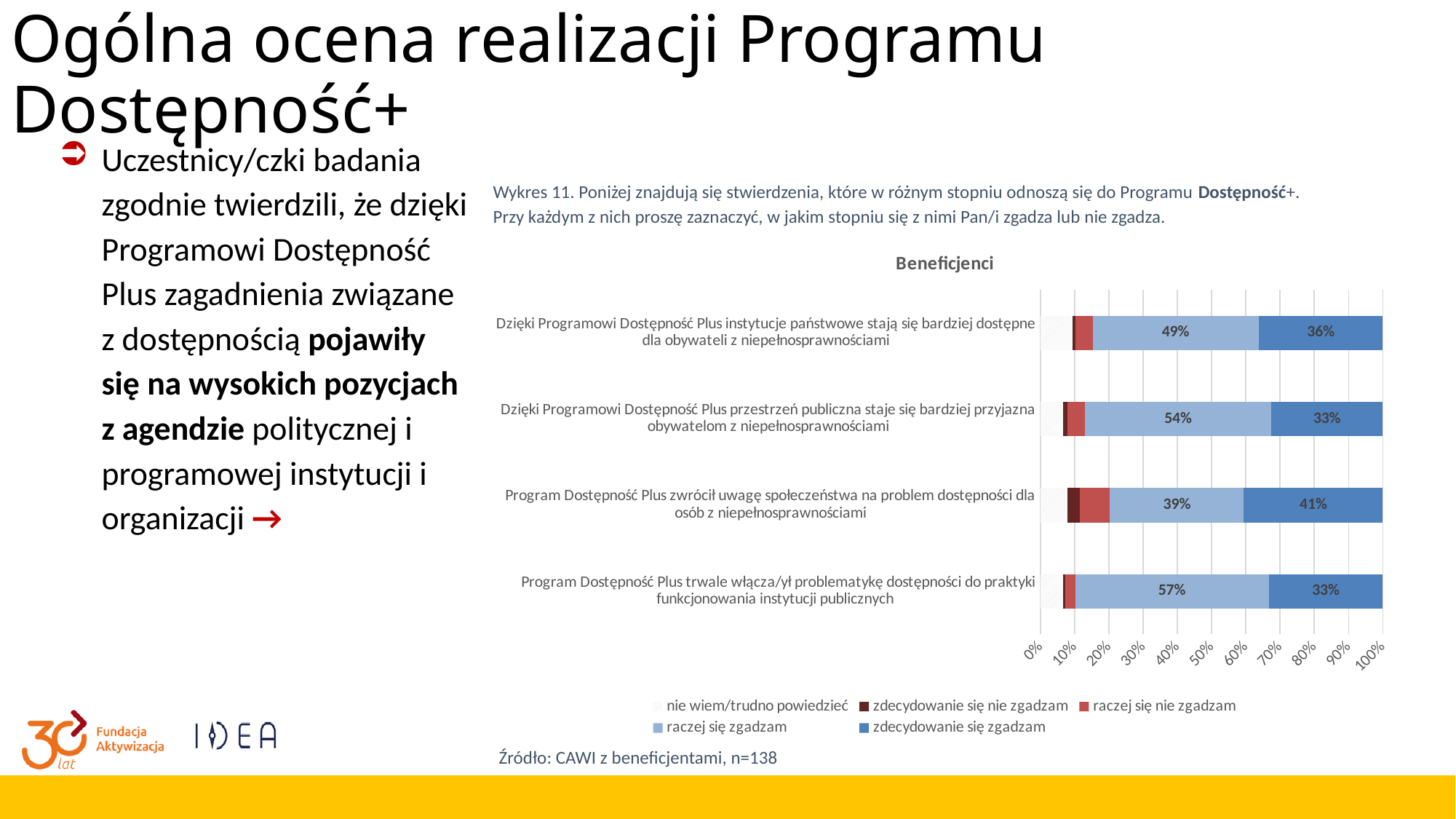
What is the "raczej się zgadzam" value for the statement that dzięki Programowi Dostępność Plus instytucje państwowe stają się bardziej dostępne dla obywateli z niepełnosprawnościami? 49% Which statement has the highest "raczej się zgadzam" share? Program Dostępność Plus trwale włącza/ył problematykę dostępności do praktyki funkcjonowania instytucji publicznych How many statements (bars) are shown in the chart? 4 For the statement about instytucje państwowe stają się bardziej dostępne, which is larger: the "raczej się zgadzam" share or the "zdecydowanie się zgadzam" share? raczej się zgadzam Which statement has the highest "zdecydowanie się zgadzam" share? Program Dostępność Plus zwrócił uwagę społeczeństwa na problem dostępności dla osób z niepełnosprawnościami What is the difference between the "raczej się zgadzam" and "zdecydowanie się zgadzam" shares for the statement about przestrzeń publiczna staje się bardziej przyjazna obywatelom z niepełnosprawnościami? 21 percentage points How many response categories does the legend list? 5 What type of chart is shown on the slide? Stacked bar chart What percentage of beneficiaries answered "zdecydowanie się zgadzam" to the statement that Program Dostępność Plus zwrócił uwagę społeczeństwa na problem dostępności dla osób z niepełnosprawnościami? 41% Which statement has the lowest "raczej się zgadzam" share? Program Dostępność Plus zwrócił uwagę społeczeństwa na problem dostępności dla osób z niepełnosprawnościami What is the combined share of "raczej się zgadzam" and "zdecydowanie się zgadzam" for the statement that Program Dostępność Plus trwale włącza/ył problematykę dostępności do praktyki funkcjonowania instytucji publicznych? 90% What percentage of beneficiaries answered "raczej się zgadzam" to the statement that Program Dostępność Plus trwale włącza/ył problematykę dostępności do praktyki funkcjonowania instytucji publicznych? 57%